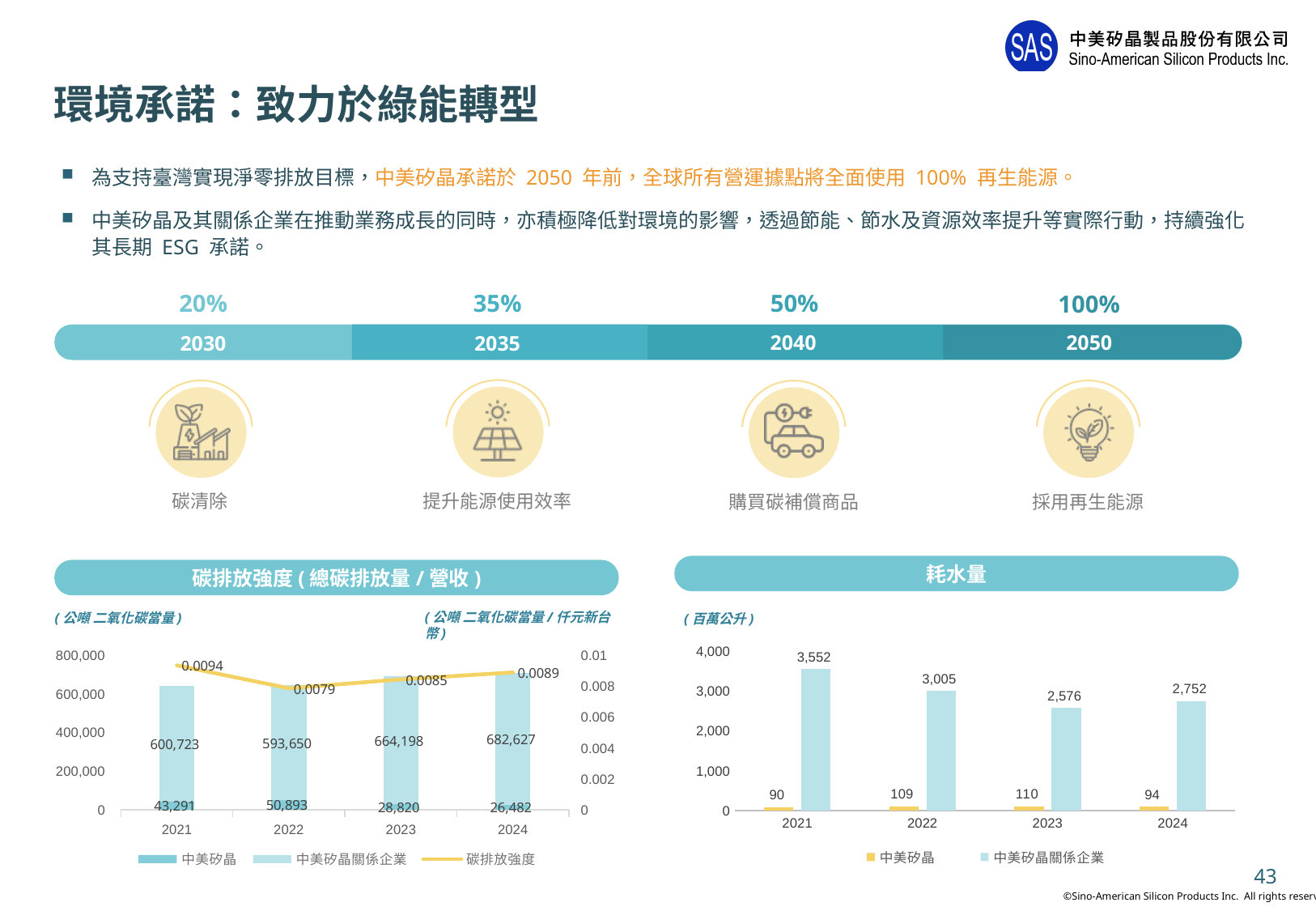
In the 碳排放強度 chart, which year has the highest 碳排放強度 value? 2021 In the 耗水量 chart, what is the difference between the 中美矽晶關係企業 values for 2021 and 2022? 547 In the 耗水量 chart, which year has the lowest value for 中美矽晶關係企業? 2023 In the 碳排放強度 chart, what is the 碳排放強度 value for 2022? 0.0079 In the 碳排放強度 chart, how many series does the legend list? 3 In the 碳排放強度 chart, what is the value for 中美矽晶關係企業 in 2024? 682,627 What kind of chart is the 耗水量 chart? bar chart In the 碳排放強度 chart, is the 中美矽晶 value for 2022 larger or smaller than the value for 2023? larger In the 碳排放強度 chart, which year has the lowest value for 中美矽晶? 2024 In the 耗水量 chart, what is the value for 中美矽晶關係企業 in 2021? 3,552 In the 耗水量 chart, how many series does the legend list? 2 In the 耗水量 chart, what is the value for 中美矽晶 in 2023? 110